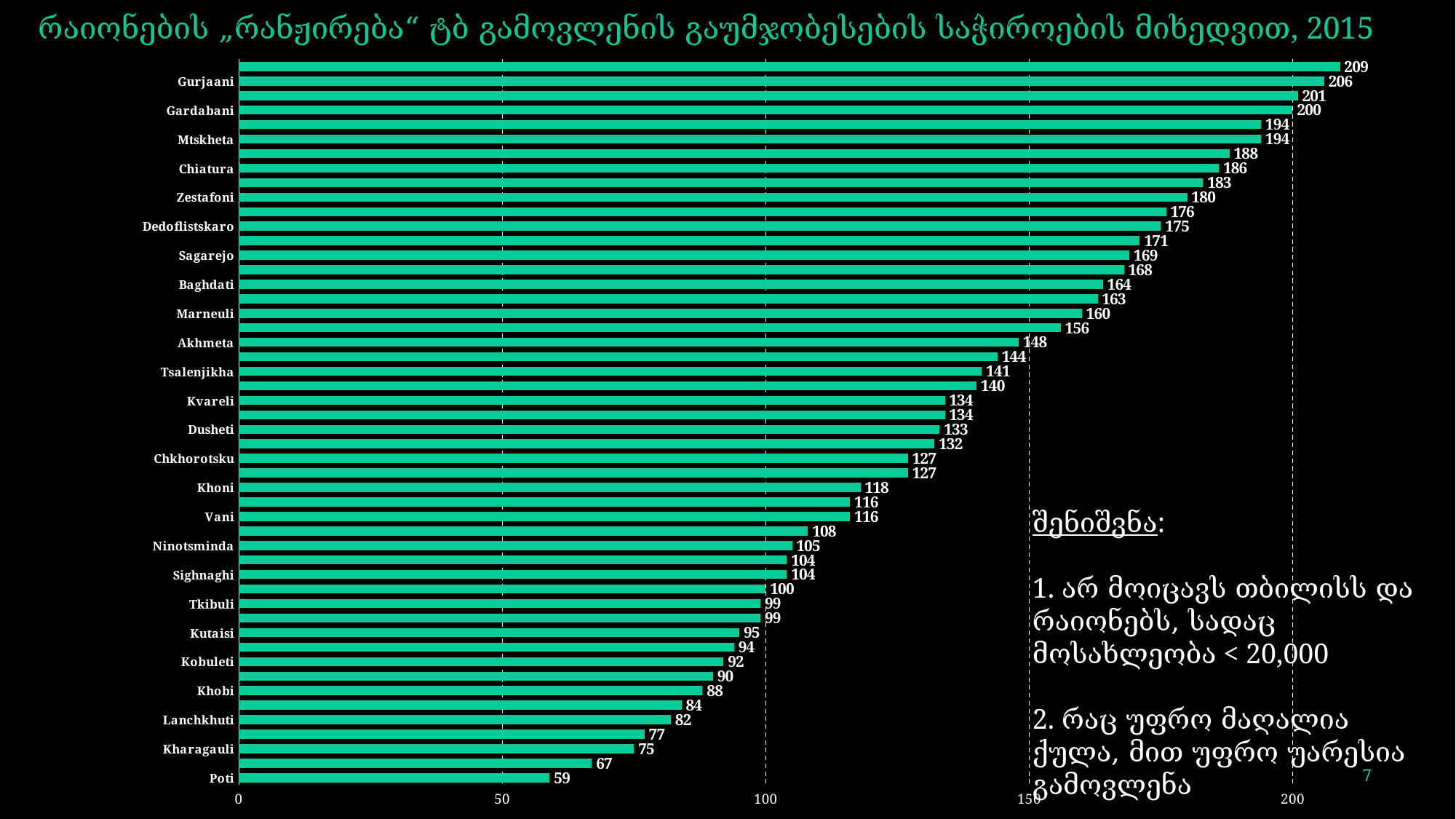
What is the value for Gurjaani? 206 Is the value for Kobuleti greater or less than 100? less What is the value for Poti? 59 How many bars are plotted on the chart? 50 What is the largest value shown on the chart? 209 Which labelled district has the lowest value? Poti What kind of chart is shown on the slide? bar chart What is the difference between the values for Gurjaani and Poti? 147 What is the smallest value shown on the chart? 59 What is the value for Dusheti? 133 Which has a larger value, Kutaisi or Khobi? Kutaisi Which year is mentioned in the chart title? 2015